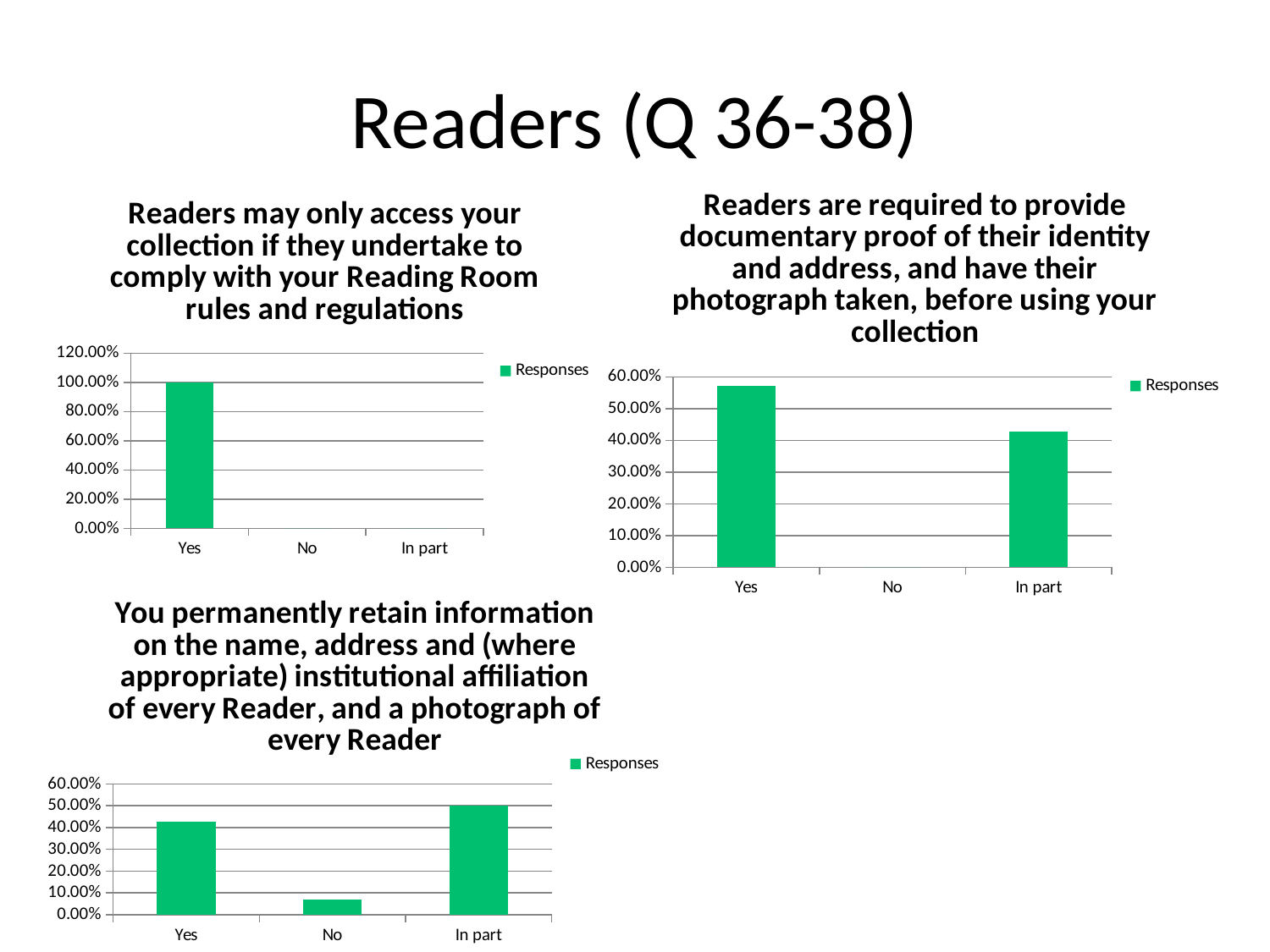
In the chart titled "You permanently retain information on the name, address and (where appropriate) institutional affiliation of every Reader, and a photograph of every Reader", is the value for Yes greater or less than 40.00%? greater How many categories are shown on the x axis of the chart titled "Readers are required to provide documentary proof of their identity and address, and have their photograph taken, before using your collection"? 3 In the chart titled "Readers may only access your collection if they undertake to comply with your Reading Room rules and regulations", which category has the highest value? Yes In the chart titled "You permanently retain information on the name, address and (where appropriate) institutional affiliation of every Reader, and a photograph of every Reader", which is larger, Yes or In part? In part In the chart titled "Readers are required to provide documentary proof of their identity and address, and have their photograph taken, before using your collection", is the value for Yes greater or less than 50.00%? greater In the chart titled "You permanently retain information on the name, address and (where appropriate) institutional affiliation of every Reader, and a photograph of every Reader", which category has the lowest value? No What kind of chart is the chart titled "You permanently retain information on the name, address and (where appropriate) institutional affiliation of every Reader, and a photograph of every Reader"? Bar chart In the chart titled "Readers are required to provide documentary proof of their identity and address, and have their photograph taken, before using your collection", which category has the highest value? Yes In the chart titled "You permanently retain information on the name, address and (where appropriate) institutional affiliation of every Reader, and a photograph of every Reader", is the value for No greater or less than 10.00%? less How many series does the legend list in the chart titled "Readers may only access your collection if they undertake to comply with your Reading Room rules and regulations"? 1 In the chart titled "Readers may only access your collection if they undertake to comply with your Reading Room rules and regulations", what is the value for Yes? 100.00%